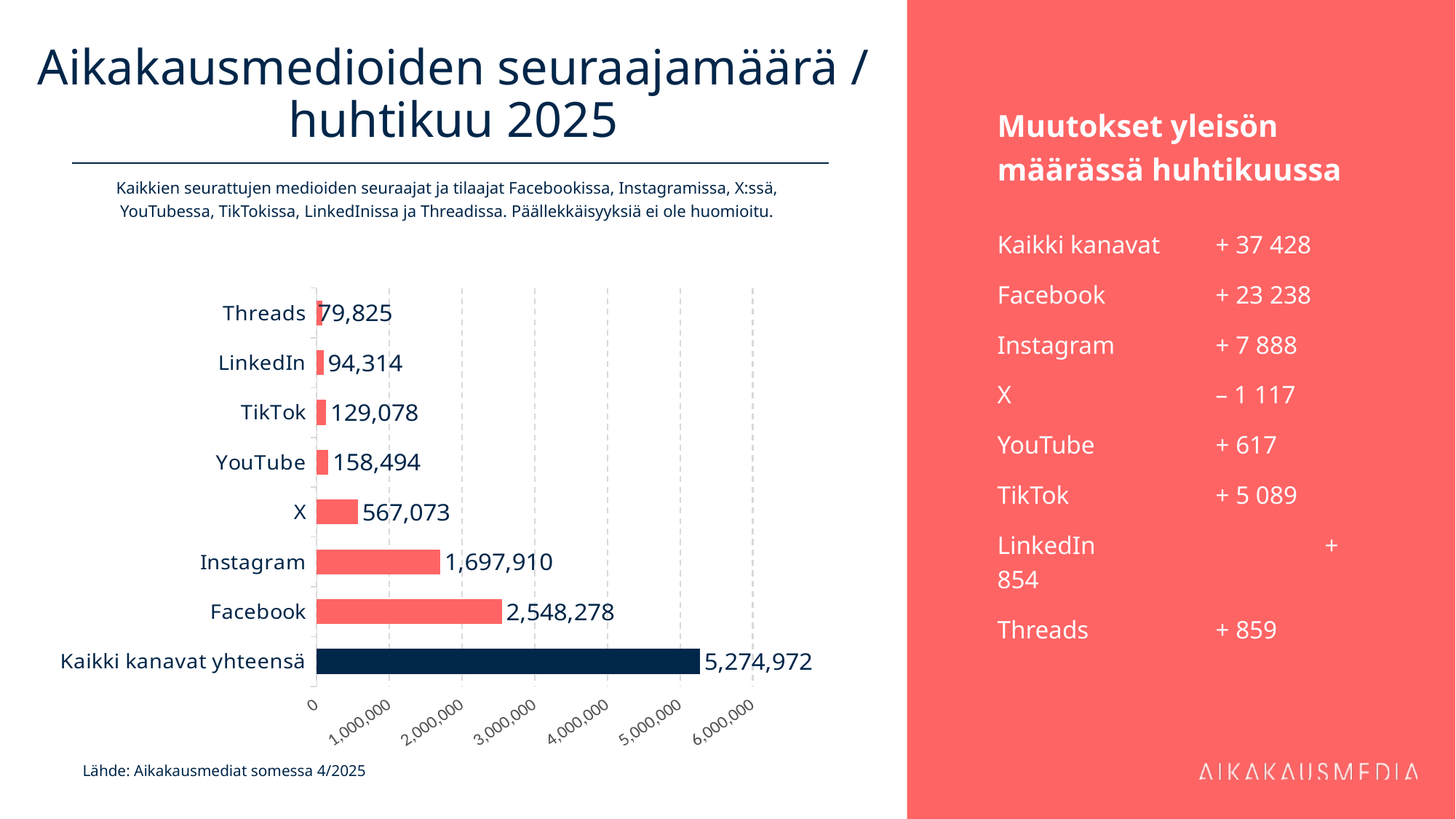
What is the value for Facebook in the chart? 2,548,278 Which category has the lowest value in the chart? Threads Which individual channel (excluding the total bar) has the highest value? Facebook What is the value for Threads in the chart? 79,825 Which is larger, the value for X or the value for YouTube? X What is the difference between the values for Facebook and Instagram? 850,368 Which bar in the chart is coloured dark navy instead of red? Kaikki kanavat yhteensä Is the value for Facebook greater or less than 2,000,000? greater How many bars are shown in the chart? 8 What is the value for Instagram in the chart? 1,697,910 What kind of chart is shown on the slide? Bar chart What is the value for Kaikki kanavat yhteensä in the chart? 5,274,972